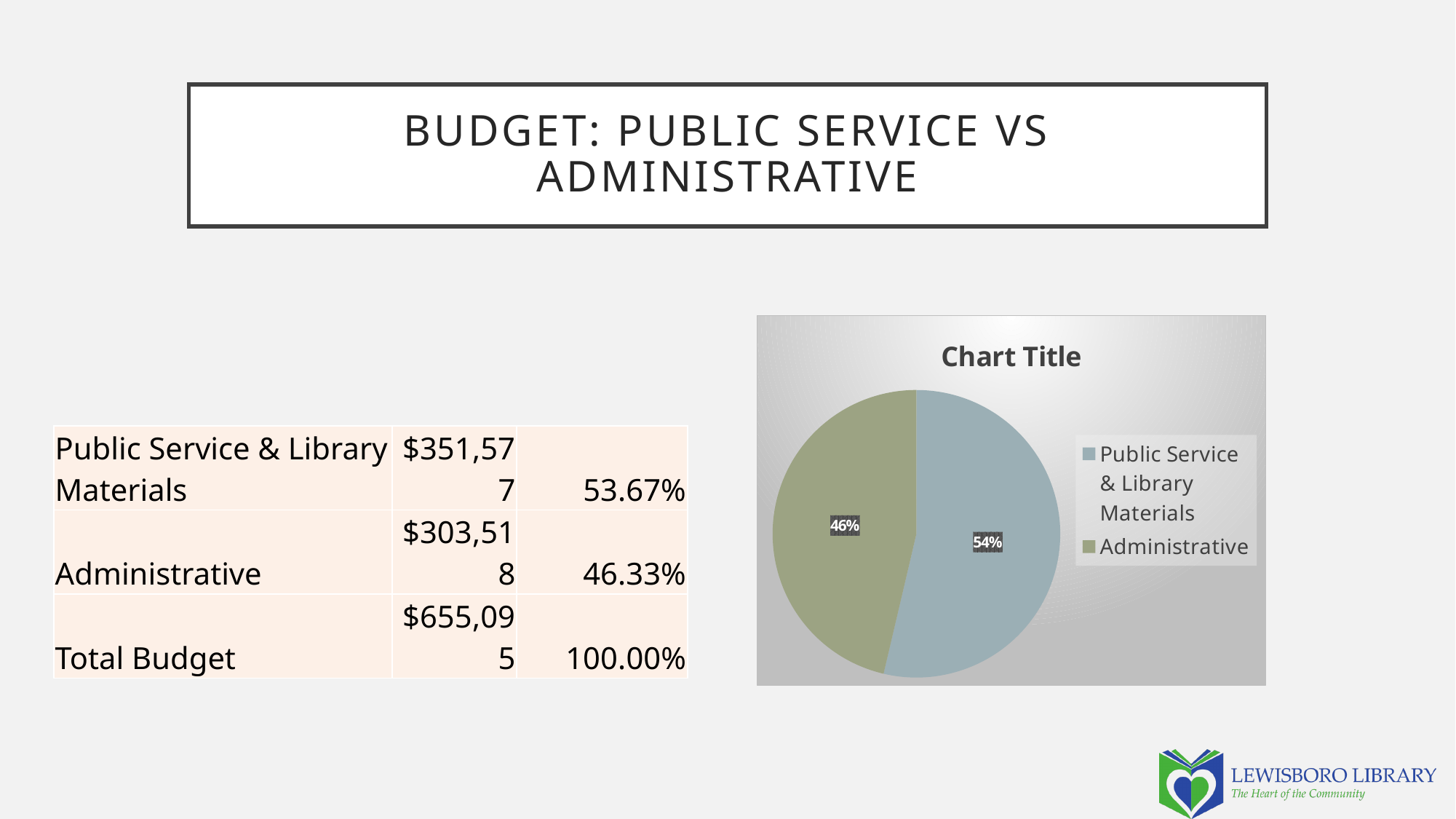
What kind of chart is shown on the slide? pie chart What percentage of the pie does the Public Service & Library Materials slice represent? 54% What percentage of the pie does the Administrative slice represent? 46% By how many percentage points does the Public Service & Library Materials slice exceed the Administrative slice? 8 percentage points Which is larger in the pie chart, Public Service & Library Materials or Administrative? Public Service & Library Materials How many slices does the pie chart have? 2 What is the title shown above the pie chart? Chart Title Which slice of the pie chart is the largest? Public Service & Library Materials How many entries does the pie chart's legend list? 2 Which legend entry is shown in the green-grey colour in the pie chart? Administrative Which slice of the pie chart is the smallest? Administrative